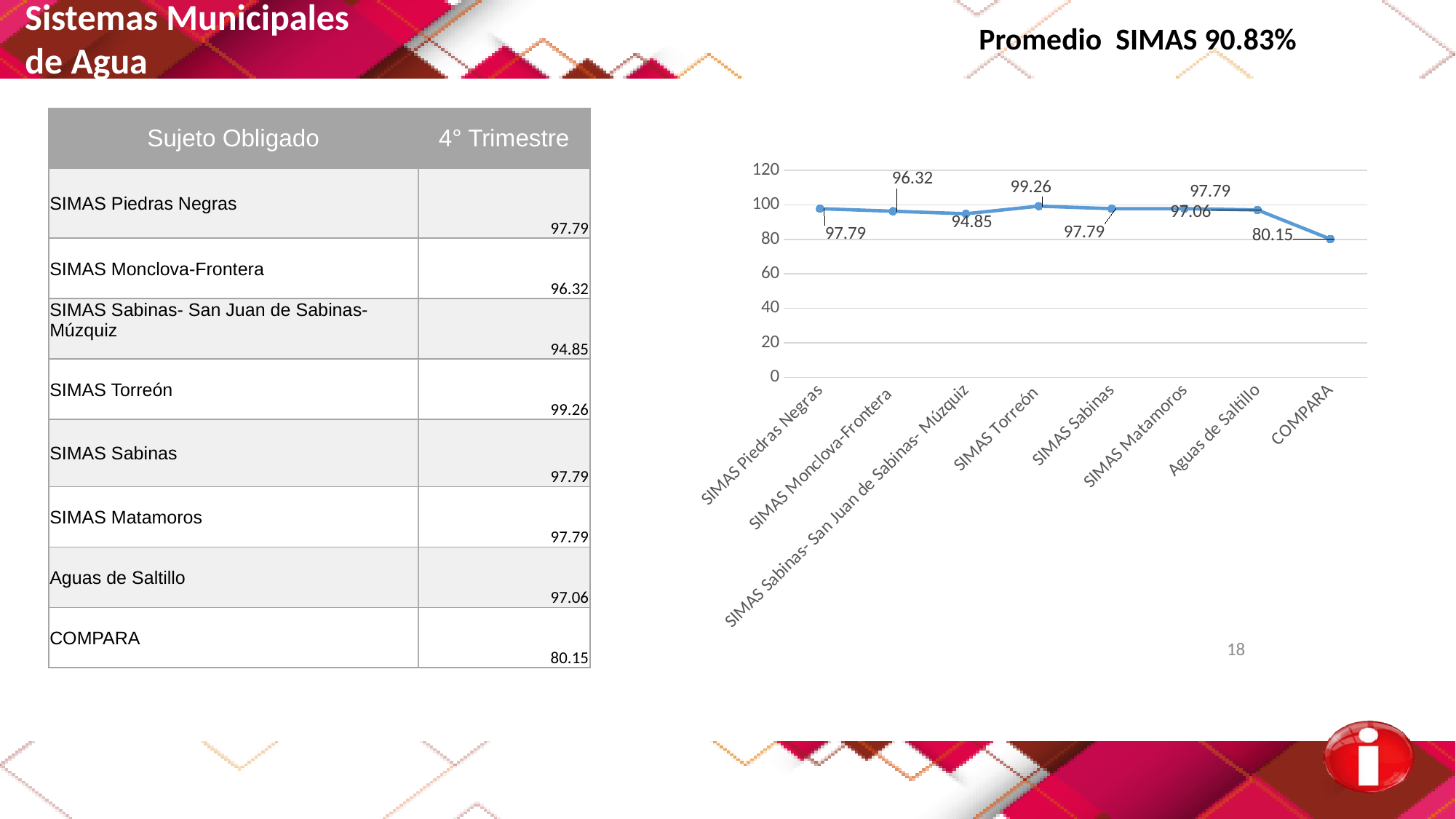
What is the highest value shown on the chart's y axis? 120 Which category has the lowest value in the chart? COMPARA What is the value for Aguas de Saltillo in the chart? 97.06 How many categories are plotted on the x axis of the chart? 8 What kind of chart is shown on the slide? line chart Which is larger, the value for SIMAS Monclova-Frontera or the value for SIMAS Sabinas- San Juan de Sabinas- Múzquiz? SIMAS Monclova-Frontera What is the value for SIMAS Torreón in the chart? 99.26 Is the value for COMPARA greater or less than 100? less What is the difference between the values for SIMAS Torreón and COMPARA? 19.11 Which category has the highest value in the chart? SIMAS Torreón What is the value for SIMAS Sabinas- San Juan de Sabinas- Múzquiz in the chart? 94.85 What is the value for COMPARA in the chart? 80.15